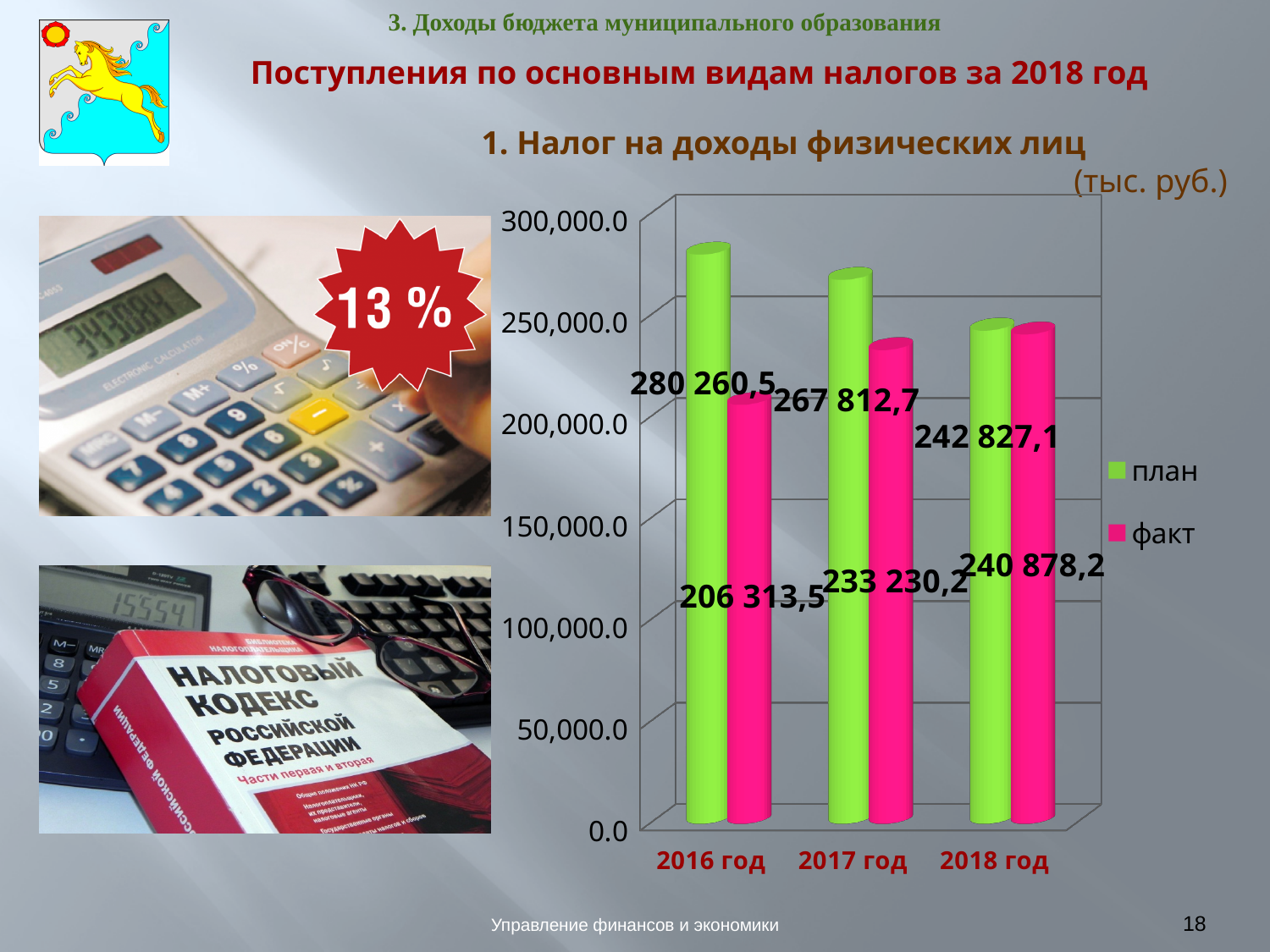
What is the difference between план and факт for 2016 год? 73 947,0 What is the план value for 2018 год? 242 827,1 Do the факт values rise or fall from 2016 год to 2018 год? rise In which year is the план value highest? 2016 год What is the difference between план and факт for 2017 год? 34 582,5 What is the факт value for 2017 год? 233 230,2 Is the факт value for 2016 год greater or less than 250,000.0? less What is the факт value for 2018 год? 240 878,2 What is the план value for 2016 год? 280 260,5 How many series does the legend list? 2 Which is larger for 2017 год, план or факт? план In which year is the факт value lowest? 2016 год